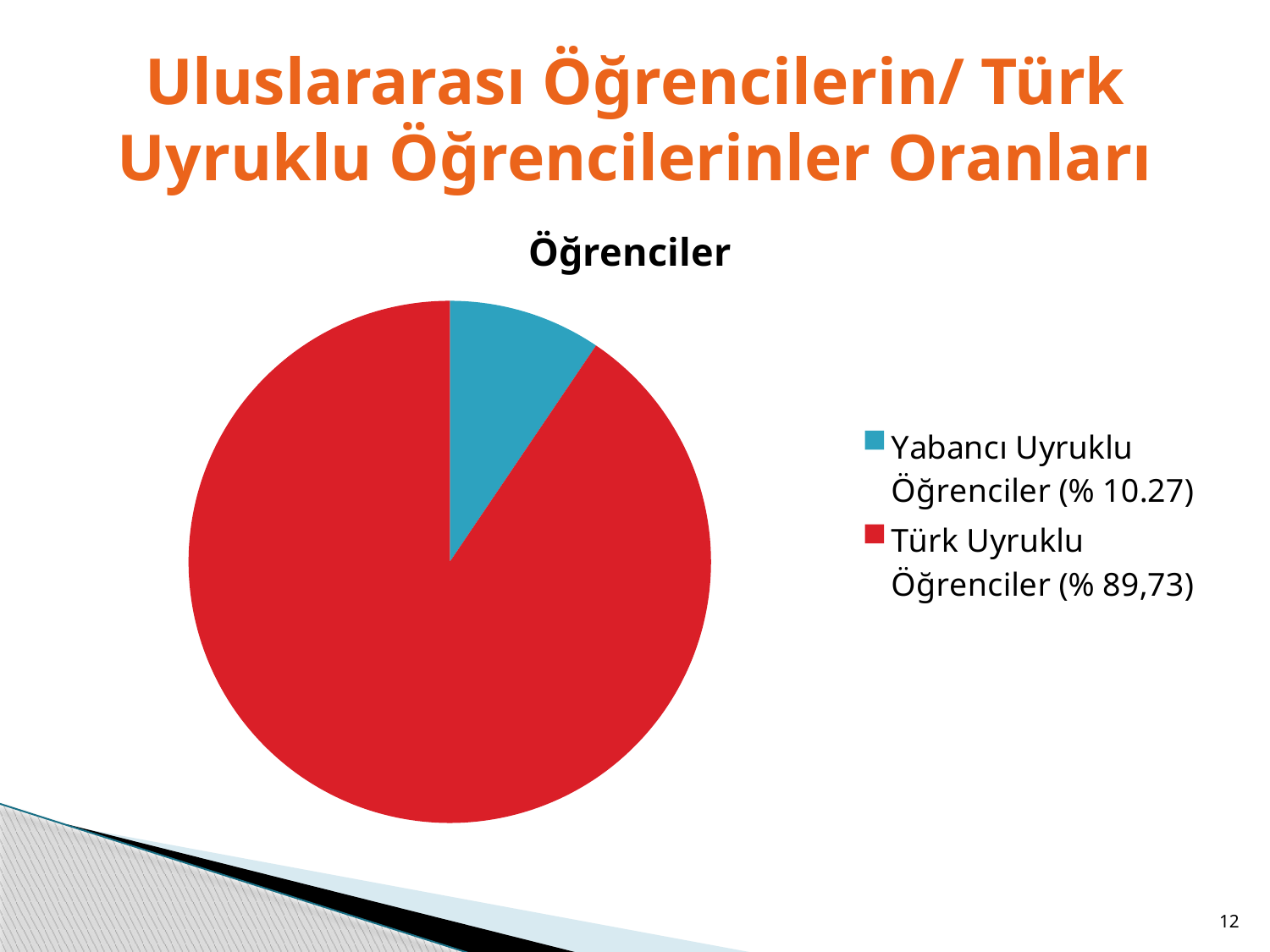
How many slices does the pie chart have? 2 What share of the pie does the Türk Uyruklu Öğrenciler slice represent? % 89,73 What kind of chart is shown on the slide? pie chart Which category has the smallest slice of the pie? Yabancı Uyruklu Öğrenciler What percentage is shown for Yabancı Uyruklu Öğrenciler? % 10.27 What colour is the slice for Yabancı Uyruklu Öğrenciler? blue How many entries does the legend list? 2 What is the title of the chart? Öğrenciler Which category has the largest slice of the pie? Türk Uyruklu Öğrenciler Which is larger, the share of Yabancı Uyruklu Öğrenciler or Türk Uyruklu Öğrenciler? Türk Uyruklu Öğrenciler What percentage is shown for Türk Uyruklu Öğrenciler? % 89,73